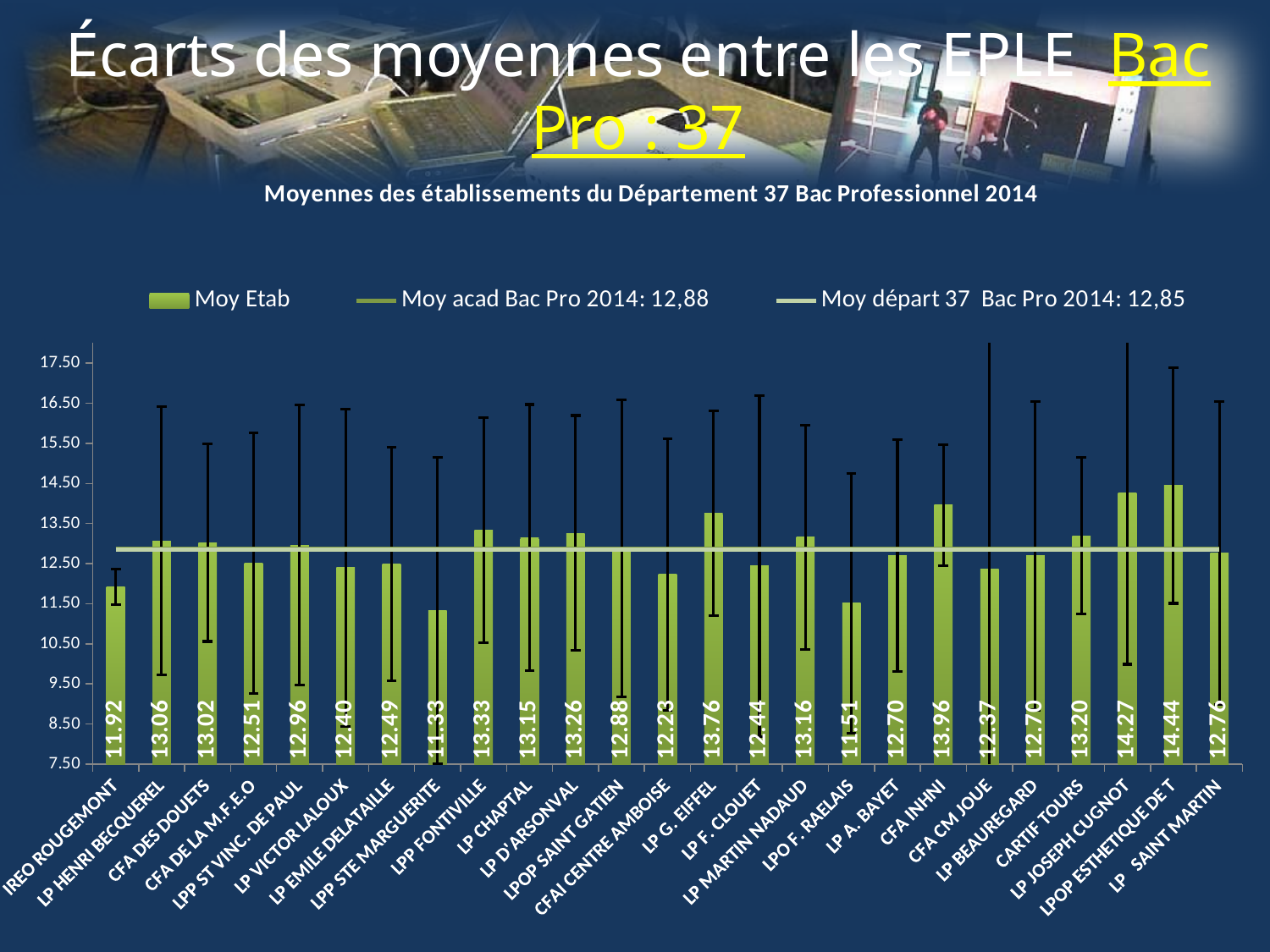
What is the difference between the values for CFA INHNI and LP A. BAYET? 1.26 Which is larger, the value for LP CHAPTAL or the value for CFAI CENTRE AMBOISE? LP CHAPTAL Which establishment has the highest value? LPOP ESTHETIQUE DE T What is the value for LP G. EIFFEL? 13.76 How many series does the legend list? 3 What is the value for IREO ROUGEMONT? 11.92 What is the value for LP JOSEPH CUGNOT? 14.27 Which establishment has the lowest value? LPP STE MARGUERITE Is the value for LPO F. RAELAIS greater or less than 12.50? less How many establishments are shown on the x axis? 25 What value does the legend give for Moy acad Bac Pro 2014? 12,88 What kind of chart is this? bar chart